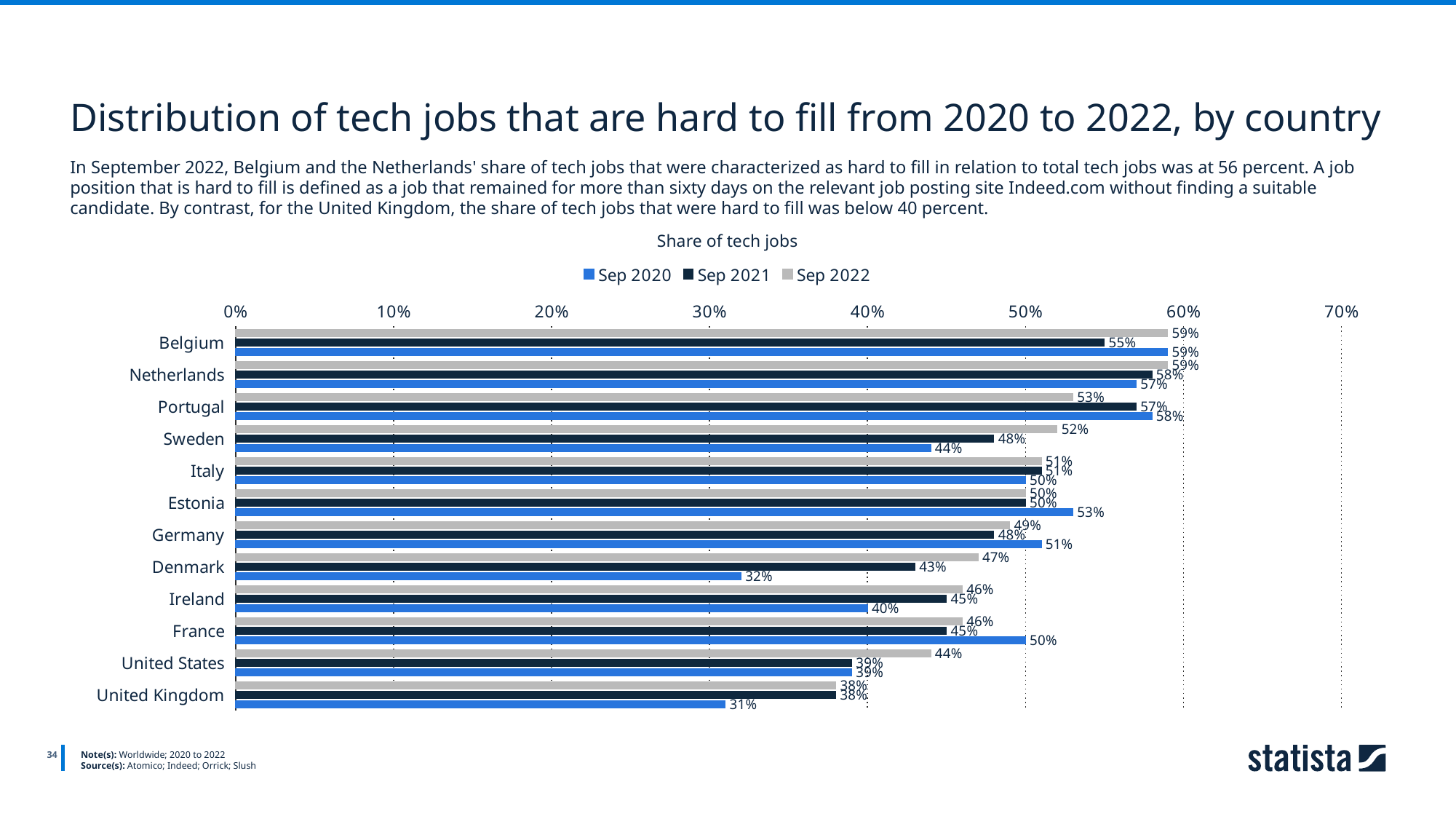
What is the title shown above the chart legend? Share of tech jobs Which country has the lowest Sep 2022 value? United Kingdom Which country has the lowest Sep 2020 value? United Kingdom What type of chart is shown on the slide? Bar chart What is the Sep 2020 value for the United Kingdom? 31% Which is larger for Portugal: the Sep 2020 value or the Sep 2022 value? Sep 2020 What is the Sep 2020 value for Denmark? 32% What is the difference between the Sep 2022 and Sep 2020 values for Denmark? 15% What is the Sep 2022 value for Sweden? 52% What is the Sep 2021 value for Belgium? 55% How many series does the legend list? 3 How many countries are shown in the chart? 12